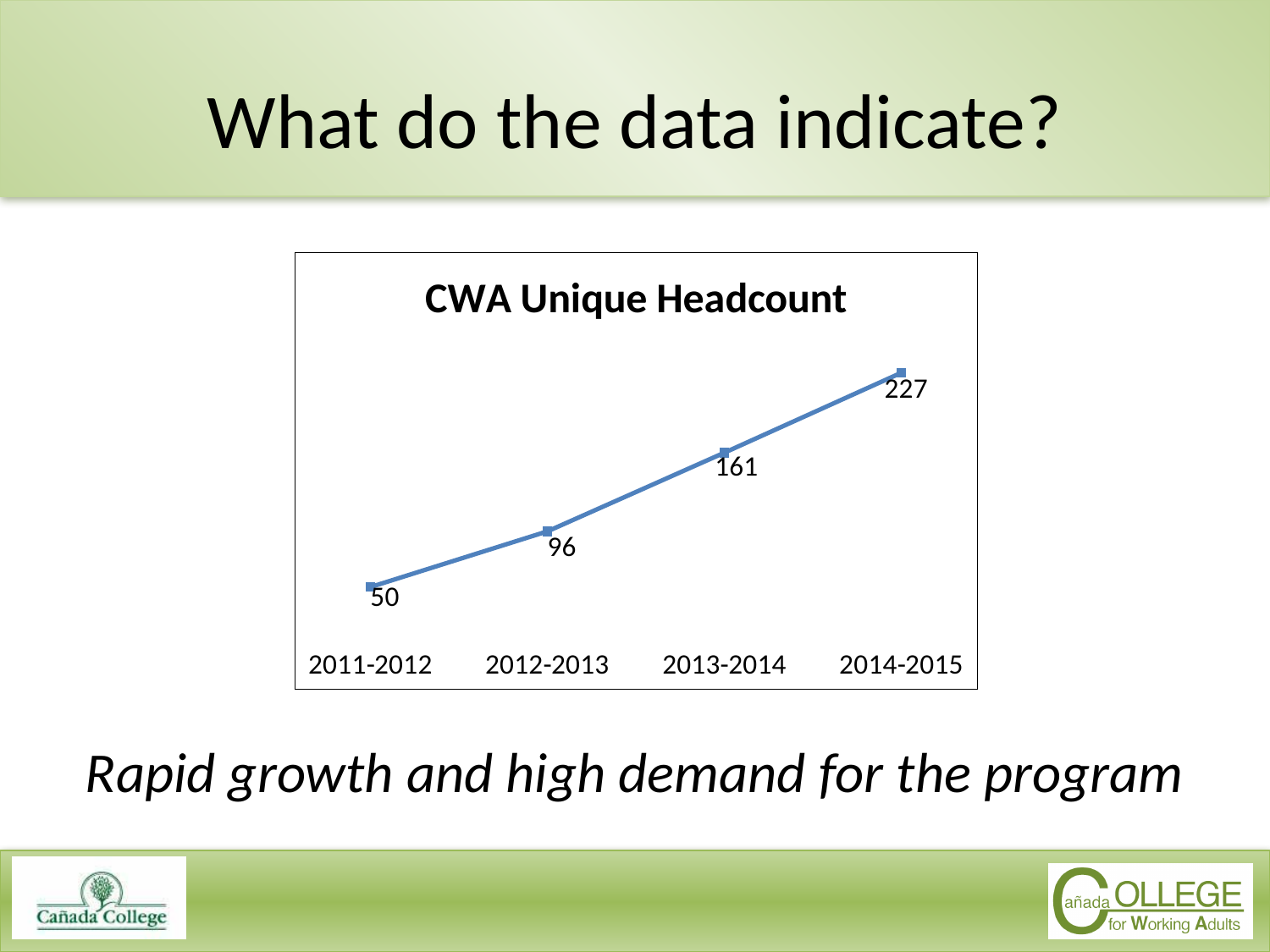
What is the CWA unique headcount for 2011-2012? 50 Which year has a larger CWA unique headcount, 2012-2013 or 2013-2014? 2013-2014 What is the CWA unique headcount for 2012-2013? 96 How many academic years are plotted in the CWA Unique Headcount chart? 4 What is the difference in CWA unique headcount between 2013-2014 and 2012-2013? 65 Which academic year has the highest CWA unique headcount? 2014-2015 What is the difference in CWA unique headcount between 2014-2015 and 2011-2012? 177 What is the CWA unique headcount for 2013-2014? 161 Which academic year has the lowest CWA unique headcount? 2011-2012 What kind of chart is used to show the CWA Unique Headcount? Line chart Does the CWA unique headcount rise or fall from 2011-2012 to 2014-2015? Rise What is the CWA unique headcount for 2014-2015? 227